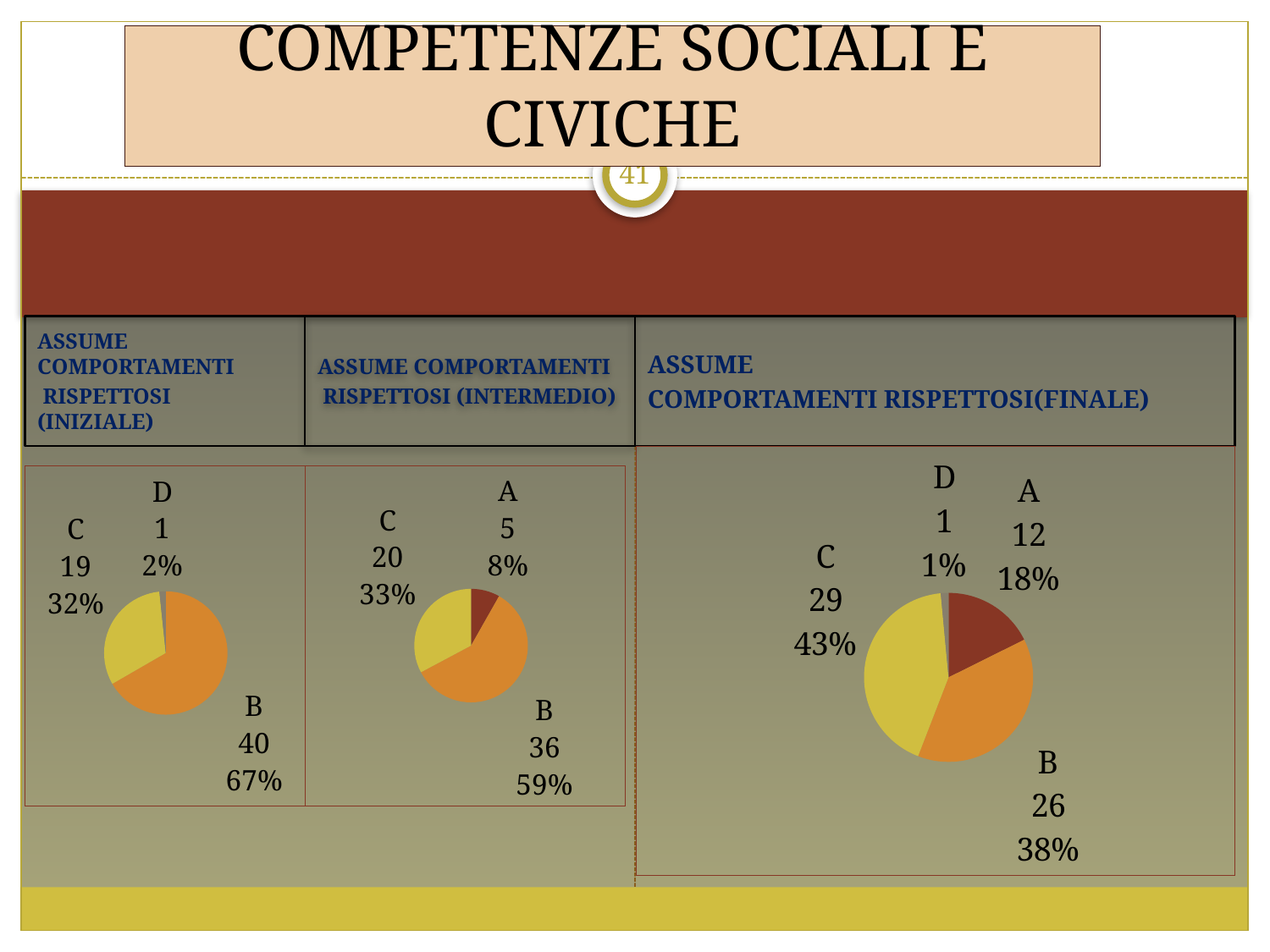
In the ASSUME COMPORTAMENTI RISPETTOSI (FINALE) chart, what is the value for C? 29 In the ASSUME COMPORTAMENTI RISPETTOSI (INIZIALE) chart, what is the value for B? 40 In the ASSUME COMPORTAMENTI RISPETTOSI (FINALE) chart, which is larger, the value for A or the value for B? B In the ASSUME COMPORTAMENTI RISPETTOSI (INIZIALE) chart, which category has the lowest value? D In the ASSUME COMPORTAMENTI RISPETTOSI (INTERMEDIO) chart, what is the value for A? 5 In the ASSUME COMPORTAMENTI RISPETTOSI (INIZIALE) chart, what share of the pie does C represent? 32% In the ASSUME COMPORTAMENTI RISPETTOSI (INTERMEDIO) chart, what share of the pie does B represent? 59% In the ASSUME COMPORTAMENTI RISPETTOSI (FINALE) chart, how many categories are shown? 4 What kind of chart is used in the ASSUME COMPORTAMENTI RISPETTOSI (FINALE) section? Pie chart In the ASSUME COMPORTAMENTI RISPETTOSI (FINALE) chart, what share of the pie does A represent? 18% In the ASSUME COMPORTAMENTI RISPETTOSI (INTERMEDIO) chart, which category has the highest value? B In the ASSUME COMPORTAMENTI RISPETTOSI (INTERMEDIO) chart, what is the difference between the values for B and C? 16